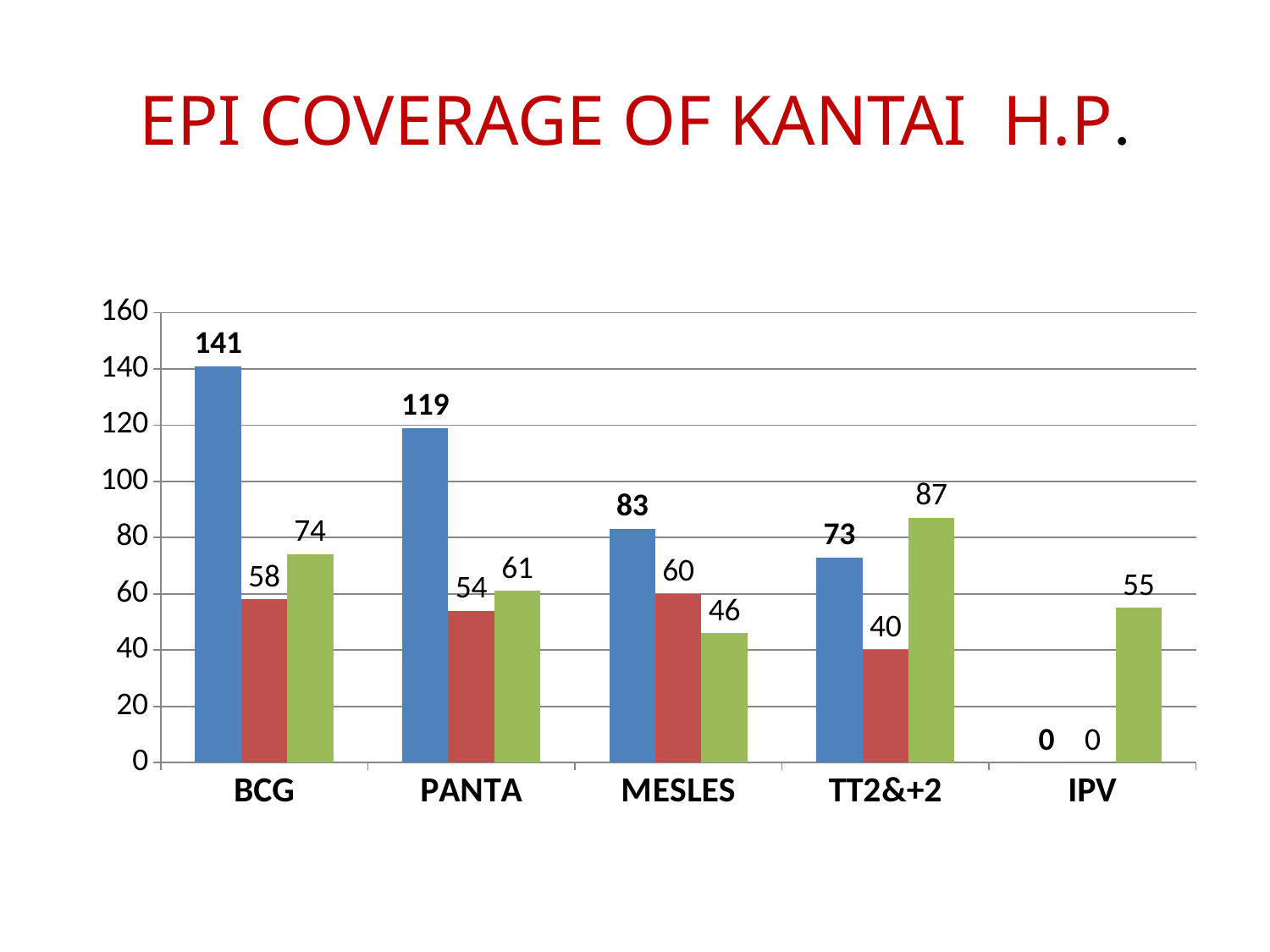
Which category has the highest blue bar? BCG What is the value of the green bar for IPV? 55 What is the value of the red bar for MESLES? 60 Which category has the lowest green bar? MESLES What is the value of the blue bar for BCG? 141 Which is larger for TT2&+2, the blue bar or the green bar? the green bar Do the blue bars rise or fall from BCG to IPV along the x axis? fall What is the title of the slide? EPI COVERAGE OF KANTAI H.P. How many categories are shown on the x axis? 5 What is the difference between the blue bar and the red bar for PANTA? 65 What is the value of the green bar for TT2&+2? 87 What kind of chart is shown on the slide? bar chart